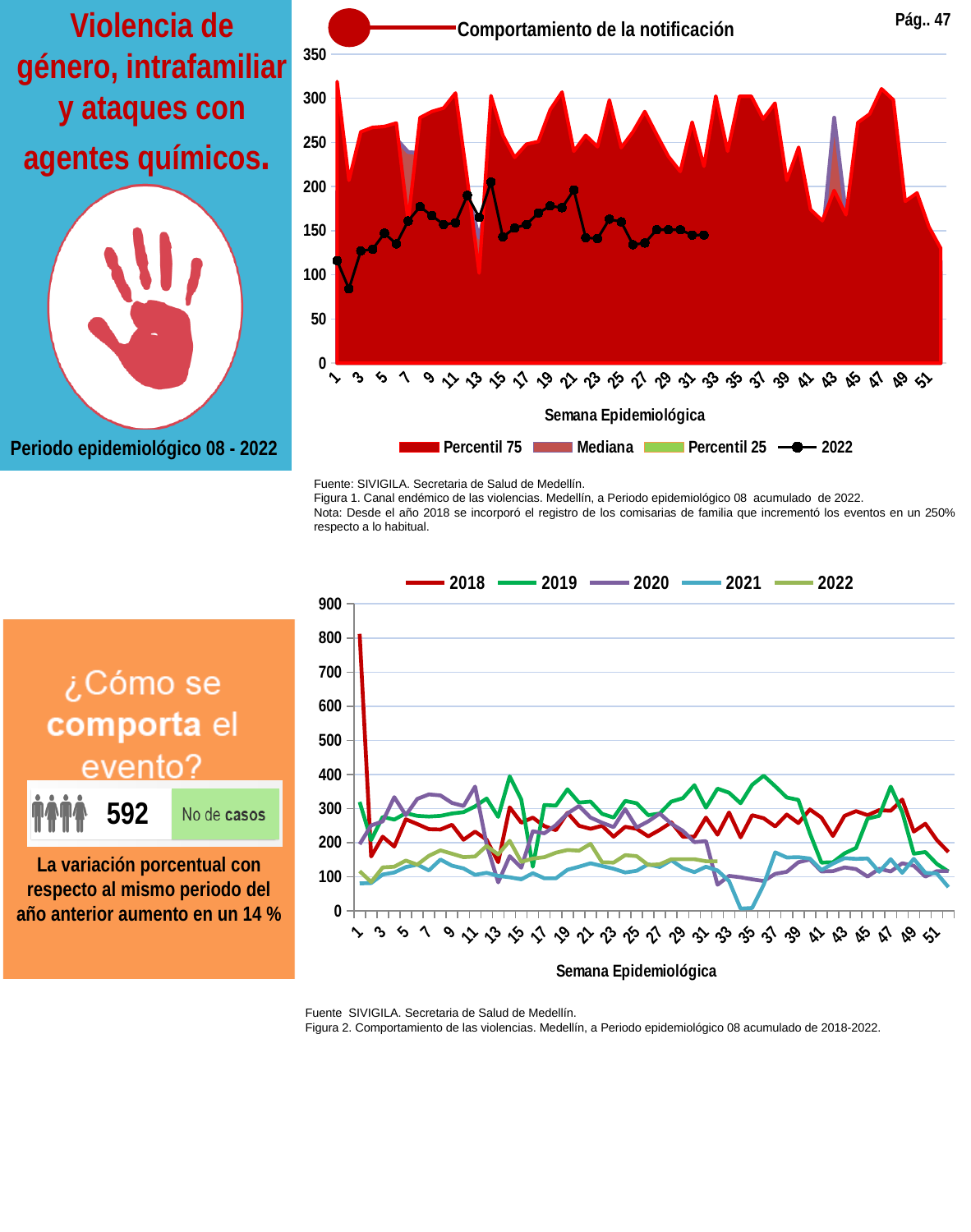
In the top chart, is the 2022 value at week 2 greater or less than 100? less In the bottom chart, is the 2019 value at week 36 greater or less than 300? greater In the bottom chart, which series has the highest value at week 1? 2018 What kind of chart is the bottom chart? line chart In the bottom chart, how many series does the legend list? 5 In the bottom chart, is the 2021 value at week 35 greater or less than 100? less In the top chart, what is the label of the x axis? Semana Epidemiológica In the top chart, how many series does the legend list? 4 What is the title of the top chart? Comportamiento de la notificación